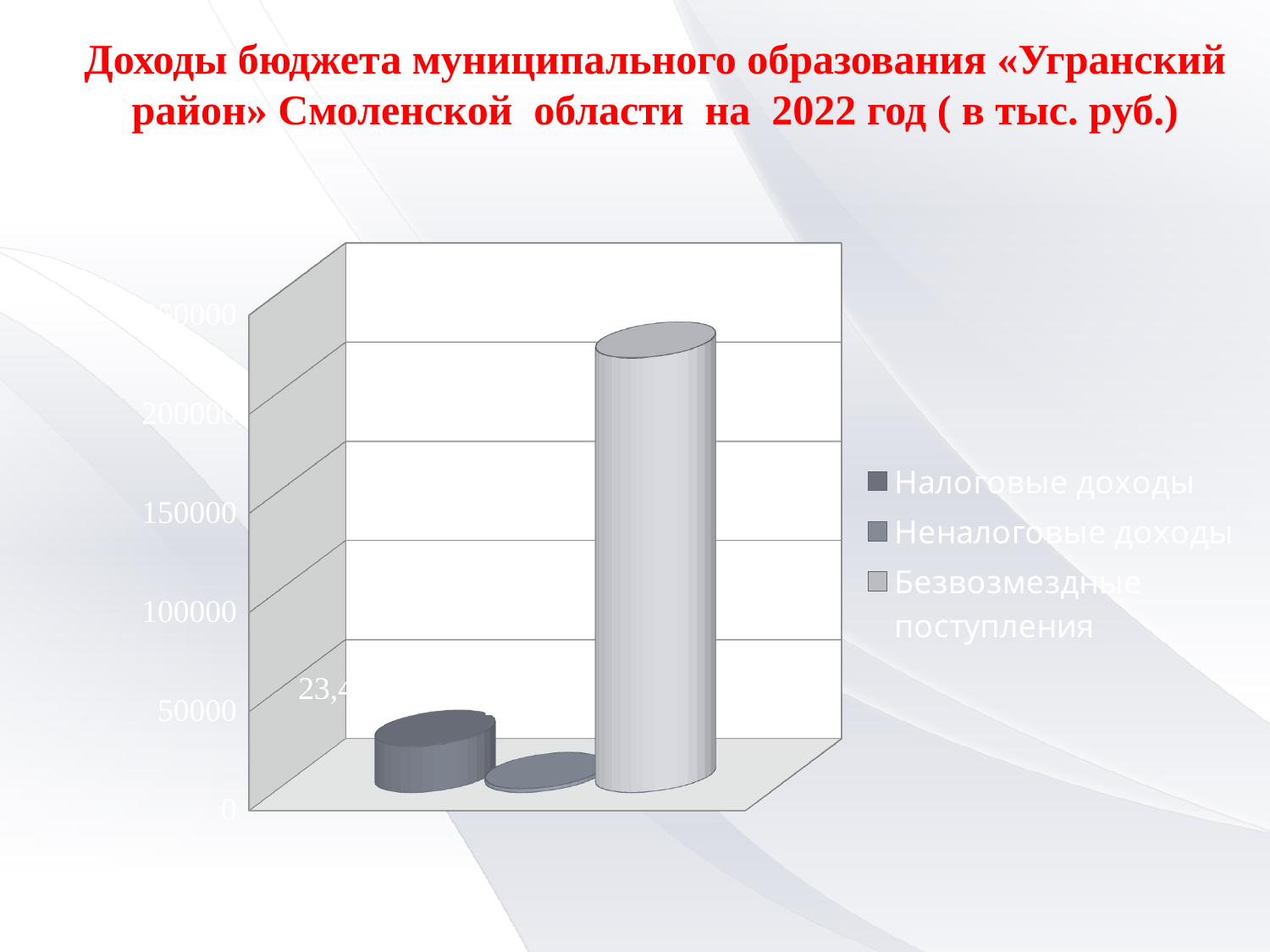
Which series has the highest value? Безвозмездные поступления Which is larger, Безвозмездные поступления or Налоговые доходы? Безвозмездные поступления For which year does the slide title say the budget revenues are shown? 2022 Which is larger, Налоговые доходы or Неналоговые доходы? Налоговые доходы Is the value for Неналоговые доходы greater or less than 50000? less In what units are the values on the chart expressed, according to the slide title? тыс. руб. Which series has the lowest value? Неналоговые доходы How many series does the legend list? 3 What kind of chart is shown on the slide? bar chart Is the value for Безвозмездные поступления greater or less than 150000? greater Is the value for Налоговые доходы greater or less than 50000? less